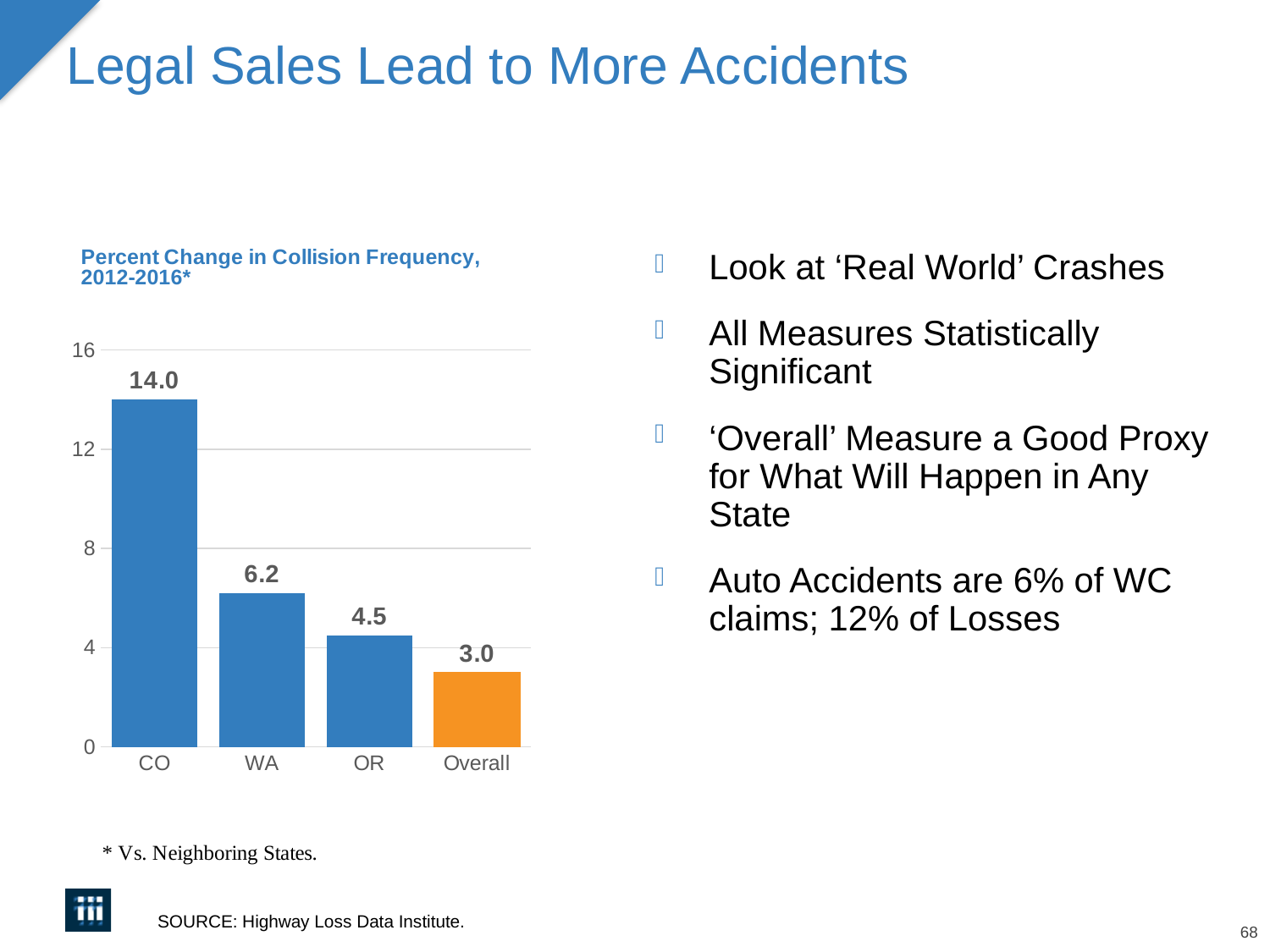
What kind of chart is shown on the slide? Bar chart What is the value shown for the Overall bar? 3.0 Which is larger, the value for OR or the value for Overall? OR Which category has the lowest value in the chart? Overall How many categories are shown in the chart? 4 What is the percent change in collision frequency for CO? 14.0 What is the value shown for WA? 6.2 Which category has the highest percent change in collision frequency? CO What is the difference between the values for CO and WA? 7.8 What is the title of the chart? Percent Change in Collision Frequency, 2012-2016* What is the value shown for OR? 4.5 Is the value for WA greater or less than 8? less